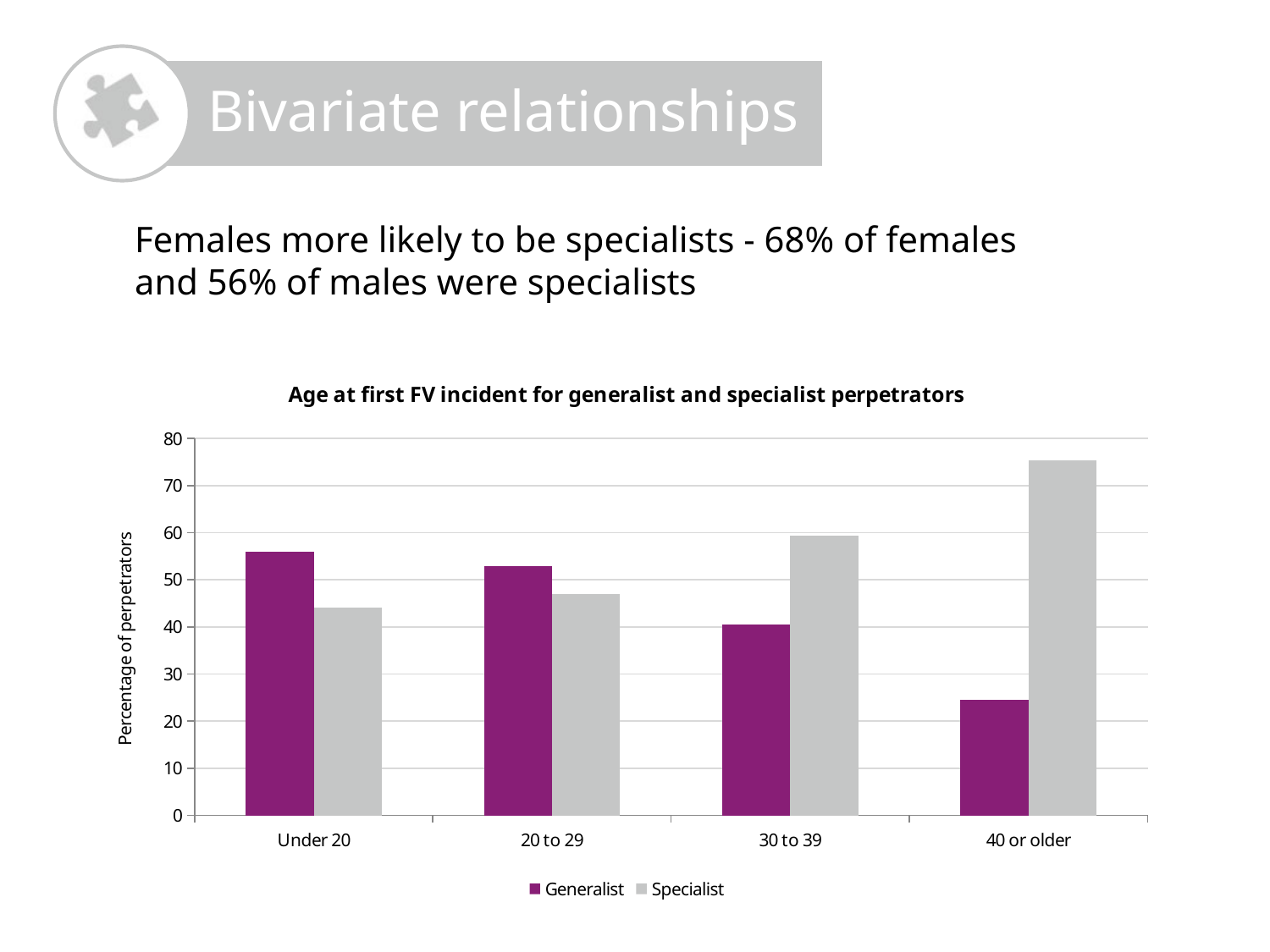
Which age category has the highest Specialist value? 40 or older Which age category has the lowest Generalist value? 40 or older What kind of chart is shown on the slide? Bar chart For the 40 or older category, which is larger, Generalist or Specialist? Specialist How many series does the chart's legend list? 2 Do the Generalist values rise or fall as the age categories move from Under 20 to 40 or older? fall Is the Specialist value for 40 or older greater or less than 70? greater What is the title of the chart's vertical axis? Percentage of perpetrators Which age category has the highest Generalist value? Under 20 How many age categories are shown on the x axis of the chart? 4 For the Under 20 category, which is larger, Generalist or Specialist? Generalist Is the Generalist value for 40 or older greater or less than 30? less